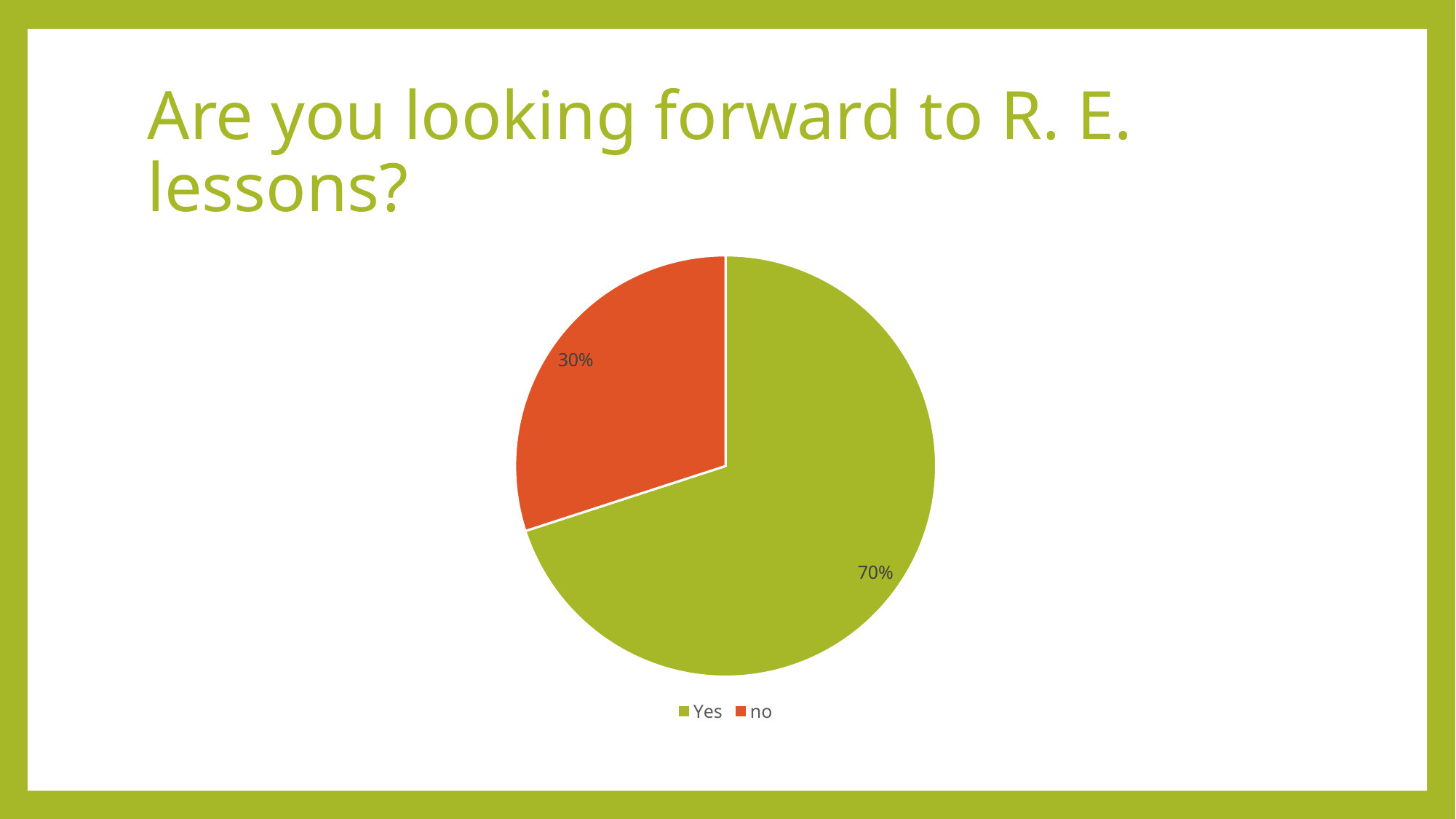
What colour is the "no" slice? orange What is the title of the slide containing the pie chart? Are you looking forward to R. E. lessons? How many slices does the pie chart have? 2 What share of the pie does the "Yes" slice represent? 70% How many entries does the legend list? 2 What share of the pie does the "no" slice represent? 30% What kind of chart is shown on the slide? pie chart Which category has the smallest slice of the pie? no What is the difference in percentage points between the "Yes" and "no" slices? 40% Which slice is larger, "Yes" or "no"? Yes Which category has the largest slice of the pie? Yes